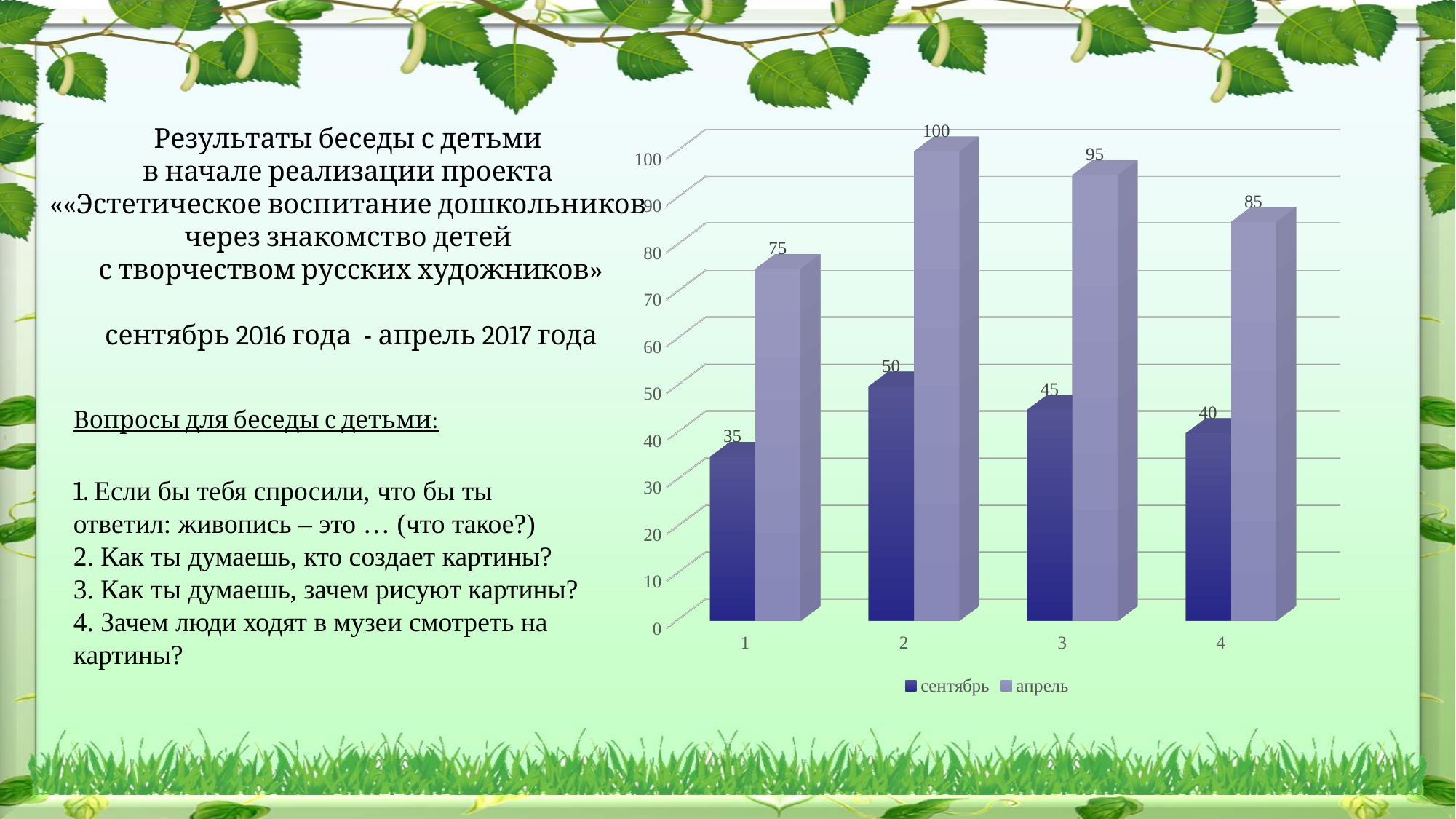
What is the value for сентябрь in category 2? 50 Which category has the lowest value for сентябрь? 1 What is the value for сентябрь in category 4? 40 How many series does the legend list? 2 What is the difference between the апрель values for category 2 and category 4? 15 What is the value for апрель in category 3? 95 Which is larger: the сентябрь value for category 3 or the сентябрь value for category 4? category 3 What is the difference between the апрель and сентябрь values in category 1? 40 How many categories are shown on the x axis? 4 What are the two series named in the legend? сентябрь and апрель Which category has the highest value for апрель? 2 What kind of chart is shown on the slide? bar chart